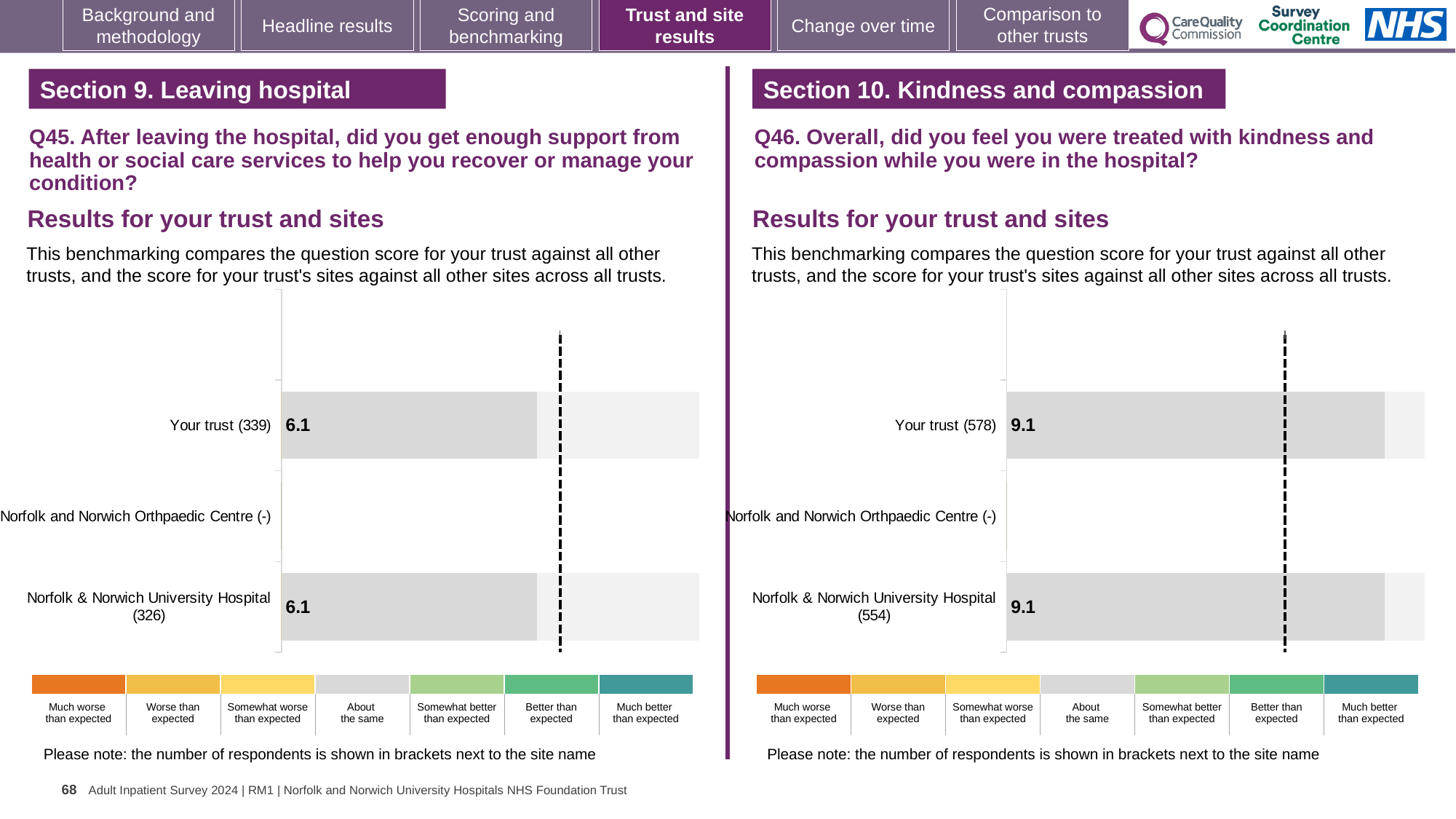
In the Q46 chart on the right, what is the score for Norfolk & Norwich University Hospital? 9.1 In the Q45 chart on the left, what is the score for Norfolk & Norwich University Hospital? 6.1 In the Q46 chart on the right, what is the difference between the score for Your trust and the score for Norfolk & Norwich University Hospital? 0 In the Q45 chart on the left, is the score for Your trust larger than, smaller than, or equal to the score for Norfolk & Norwich University Hospital? equal How many benchmark categories are shown in the colour key below the Q46 chart on the right? 7 What kind of chart is used for the Q46 results on the right? bar chart In the Q45 chart on the left, what is the score for Your trust? 6.1 How many site or trust rows are listed on the y axis of the Q45 chart on the left? 3 In the Q45 chart on the left, how many respondents are shown in brackets for Your trust? 339 In the Q46 chart on the right, what is the score for Your trust? 9.1 In the Q46 chart on the right, how many respondents are shown in brackets for Norfolk & Norwich University Hospital? 554 In the Q45 chart on the left, which row has no bar plotted? Norfolk and Norwich Orthpaedic Centre (-)